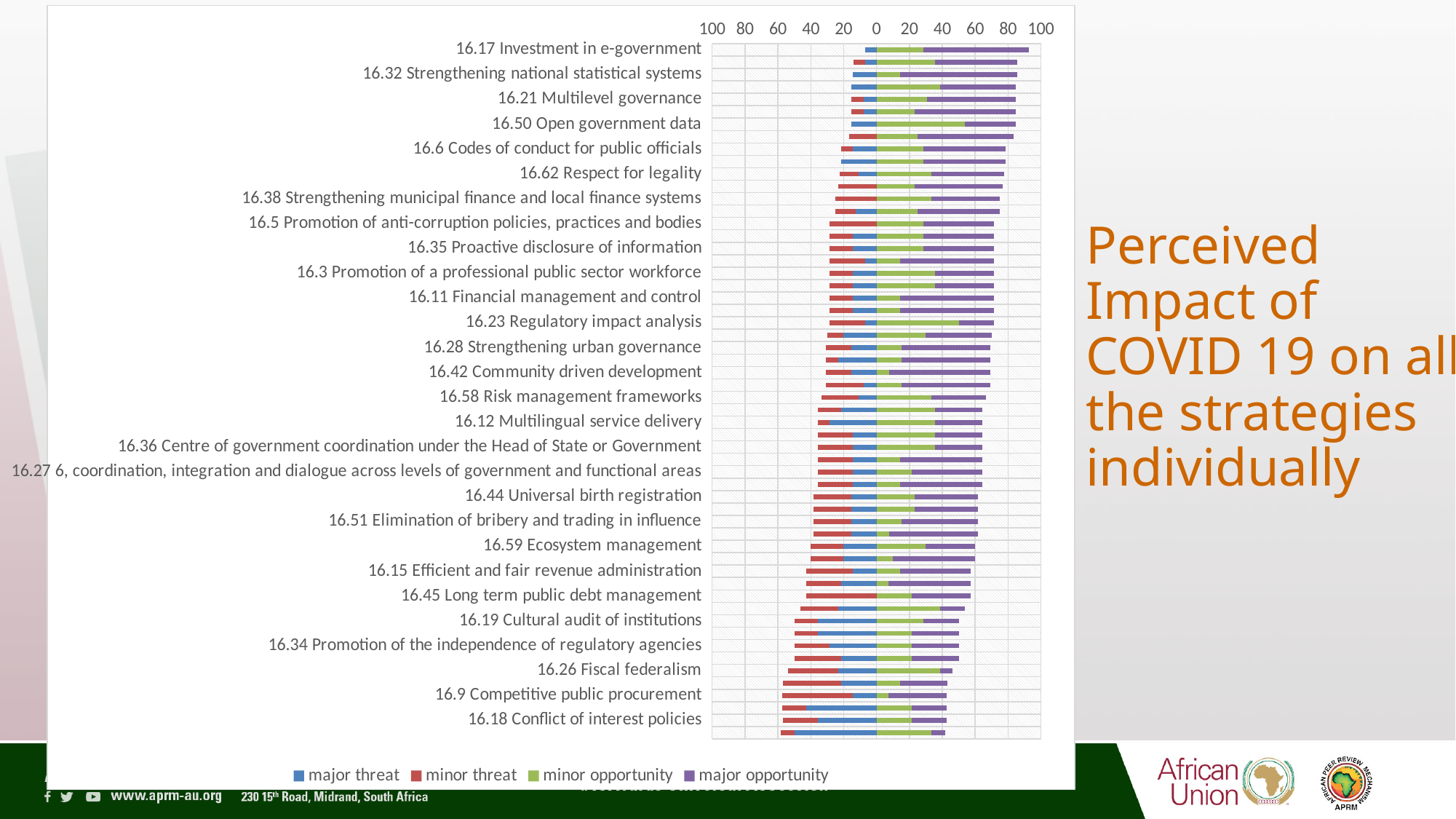
Moving from the top of the chart to the bottom, does the length of the opportunity (right-hand) side of the bars rise or fall? fall Is the threat (left-hand) side of the bar for 16.18 Conflict of interest policies greater or less than 40? greater Is the opportunity (right-hand) side of the bar for 16.17 Investment in e-government greater or less than 80? greater What are the four series named in the legend? major threat, minor threat, minor opportunity, major opportunity Is the opportunity (right-hand) side of the bar for 16.18 Conflict of interest policies greater or less than 60? less Which colour represents 'major opportunity' in the chart? purple What kind of chart is shown on the slide? bar chart Which strategy has the longest bar on the opportunity (right-hand) side of the chart? 16.17 Investment in e-government Which has a longer opportunity (right-hand) bar: 16.17 Investment in e-government or 16.18 Conflict of interest policies? 16.17 Investment in e-government Which strategy is listed at the top of the chart? 16.17 Investment in e-government How many series does the legend list? 4